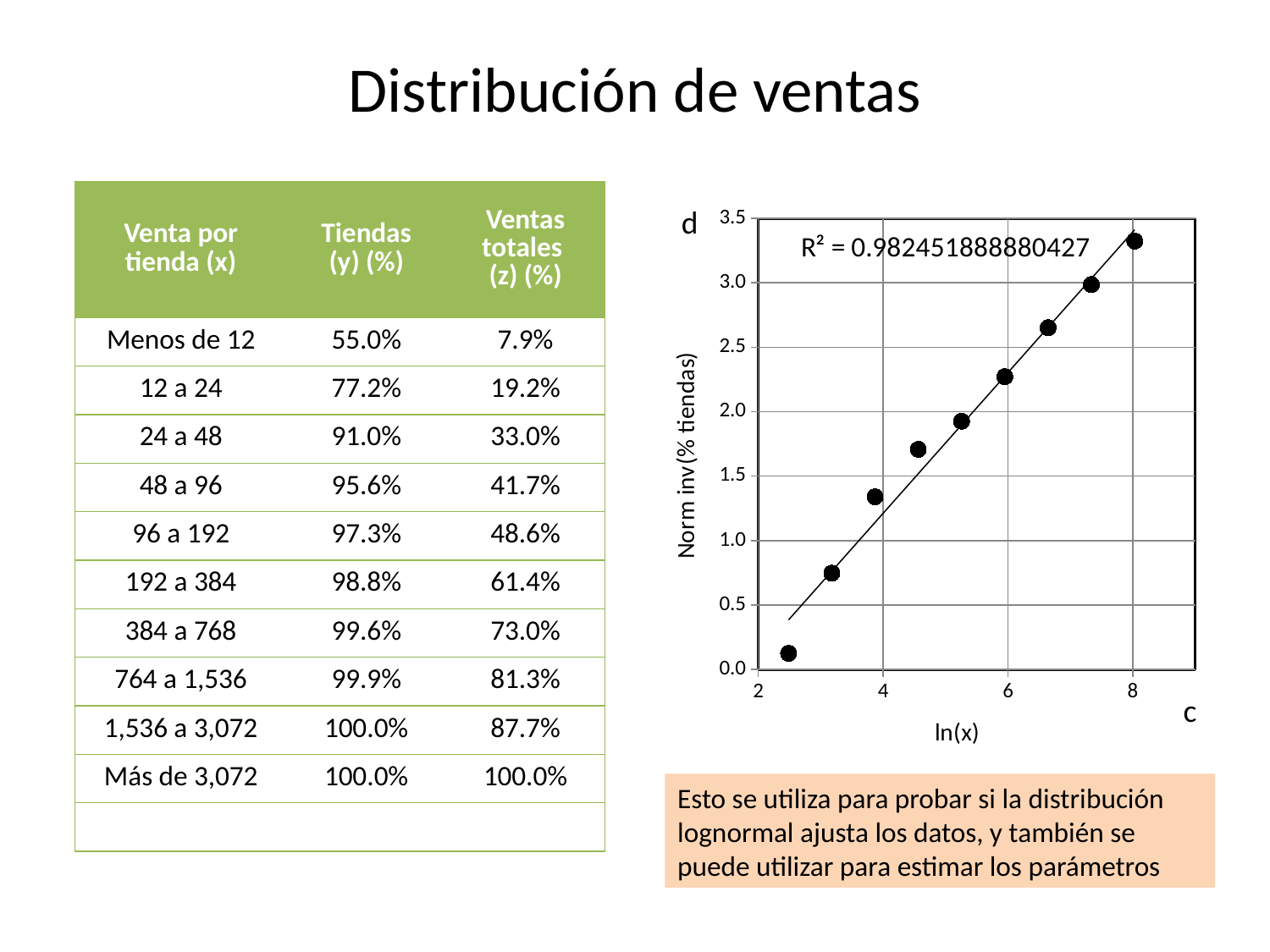
What is the R² value printed on the chart? R² = 0.982451888880427 Is the value of the rightmost data point greater or less than 3.0? greater What kind of chart is shown on the slide? scatter chart What is the title of the x axis of the chart? ln(x) Do the plotted values rise or fall as ln(x) increases? rise Which data point has the highest value: the leftmost or the rightmost? the rightmost What is the highest tick value shown on the y axis? 3.5 How many data points are plotted in the chart? 9 Is the value of the leftmost data point greater or less than 0.5? less Is the value of the data point nearest ln(x) = 6 greater or less than 2.0? greater